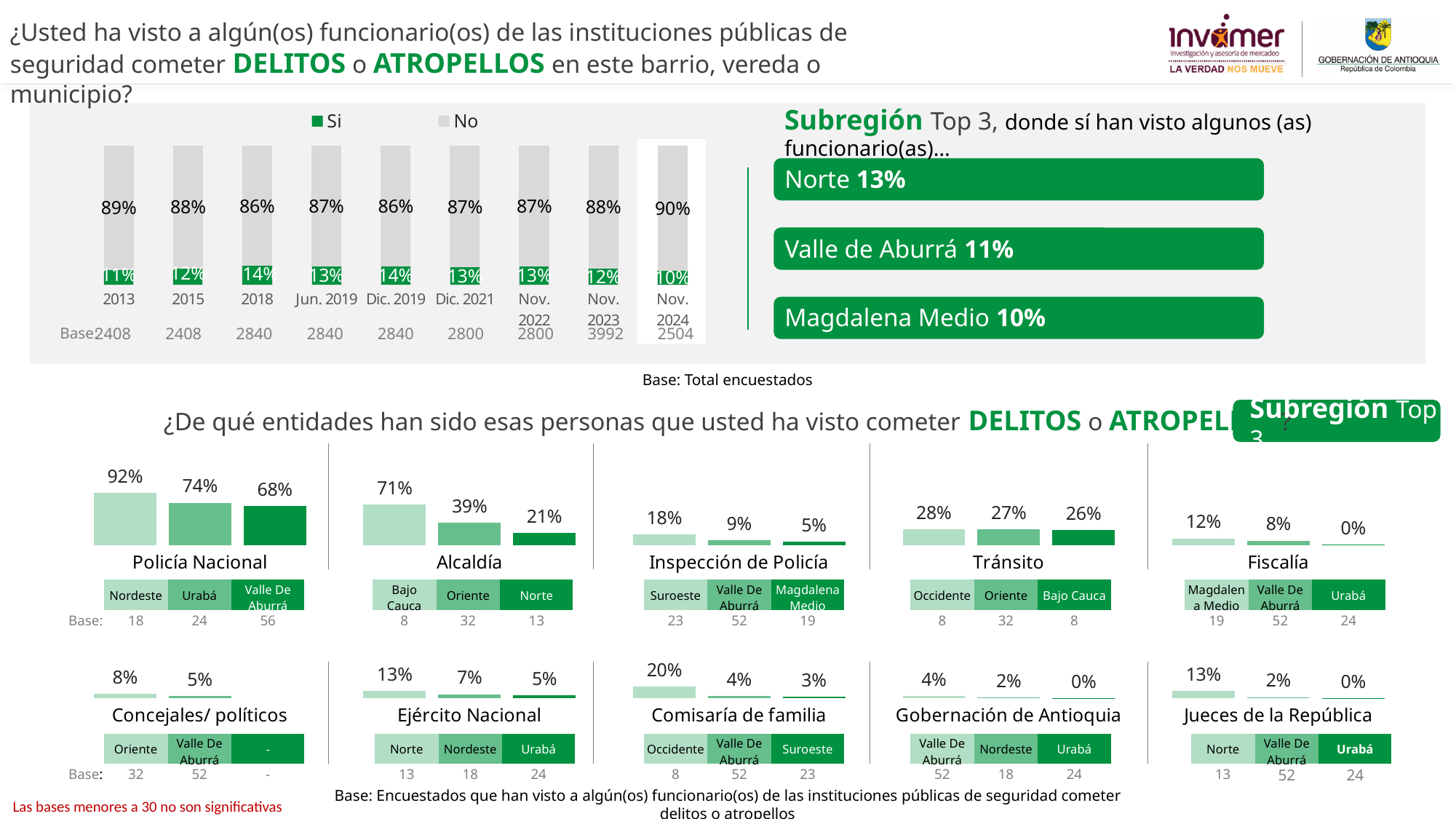
In the top stacked bar chart, what is the total of the 'Si' and 'No' values for Nov. 2023? 100% In the Inspección de Policía chart, which subregion has the lowest value? Magdalena Medio In the top stacked bar chart, how many time periods are shown along the x axis? 9 In the Comisaría de familia chart, which is larger: the value for Occidente or the value for Suroeste? Occidente In the top stacked bar chart, how many series does the legend list? 2 In the Alcaldía chart, what is the value for Bajo Cauca? 71% In the top stacked bar chart, what is the 'No' value for 2013? 89% What kind of chart is the top chart showing 'Si' and 'No' by year? Stacked bar chart In the Policía Nacional chart, which subregion has the highest value? Nordeste In the top stacked bar chart, what is the 'Si' value for Nov. 2024? 10% In the top stacked bar chart, what is the difference between the 'Si' value for 2018 and the 'Si' value for Nov. 2024? 4% In the Jueces de la República chart, what is the value for Urabá? 0%